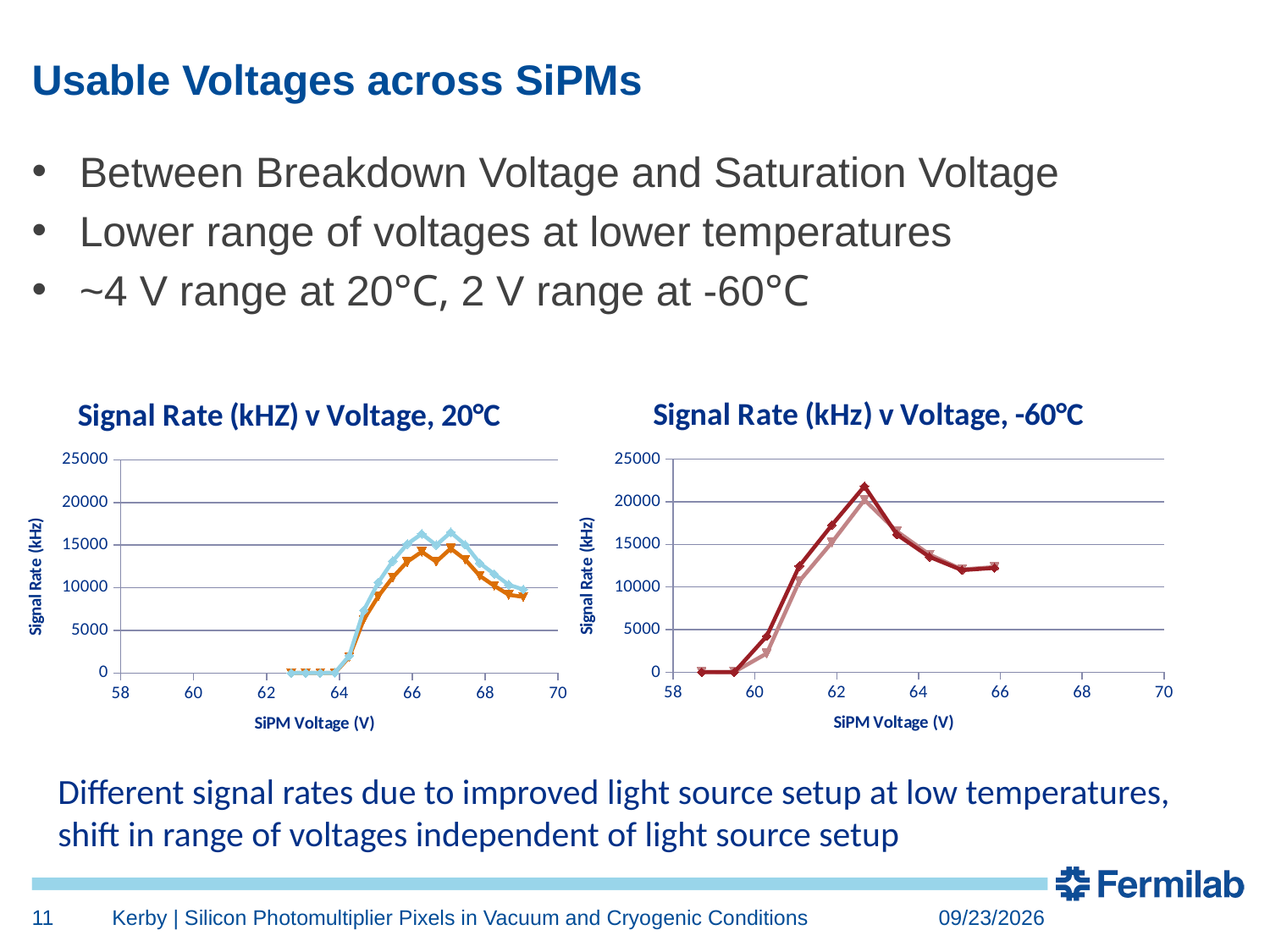
On the 'Signal Rate (kHz) v Voltage, -60°C' chart, is the peak value of the dark red line greater or less than 20000? greater How many lines are plotted on the 'Signal Rate (kHz) v Voltage, -60°C' chart? 2 What is the title of the right-hand chart? Signal Rate (kHz) v Voltage, -60°C What is the x-axis label on the 'Signal Rate (kHz) v Voltage, -60°C' chart? SiPM Voltage (V) On the 'Signal Rate (kHZ) v Voltage, 20°C' chart, is the signal rate at 63 V greater or less than 5000? less On the 'Signal Rate (kHz) v Voltage, -60°C' chart, do the values rise or fall between about 63 V and 65 V? fall On the 'Signal Rate (kHz) v Voltage, -60°C' chart, is the signal rate at 65 V greater or less than 15000? less On the 'Signal Rate (kHZ) v Voltage, 20°C' chart, do the values rise or fall between 64 V and 66 V? rise Which chart reaches a higher peak signal rate, the 20°C chart or the -60°C chart? the -60°C chart What is the maximum value shown on the y-axis of the 'Signal Rate (kHZ) v Voltage, 20°C' chart? 25000 What kind of chart is the 'Signal Rate (kHZ) v Voltage, 20°C' chart? line chart